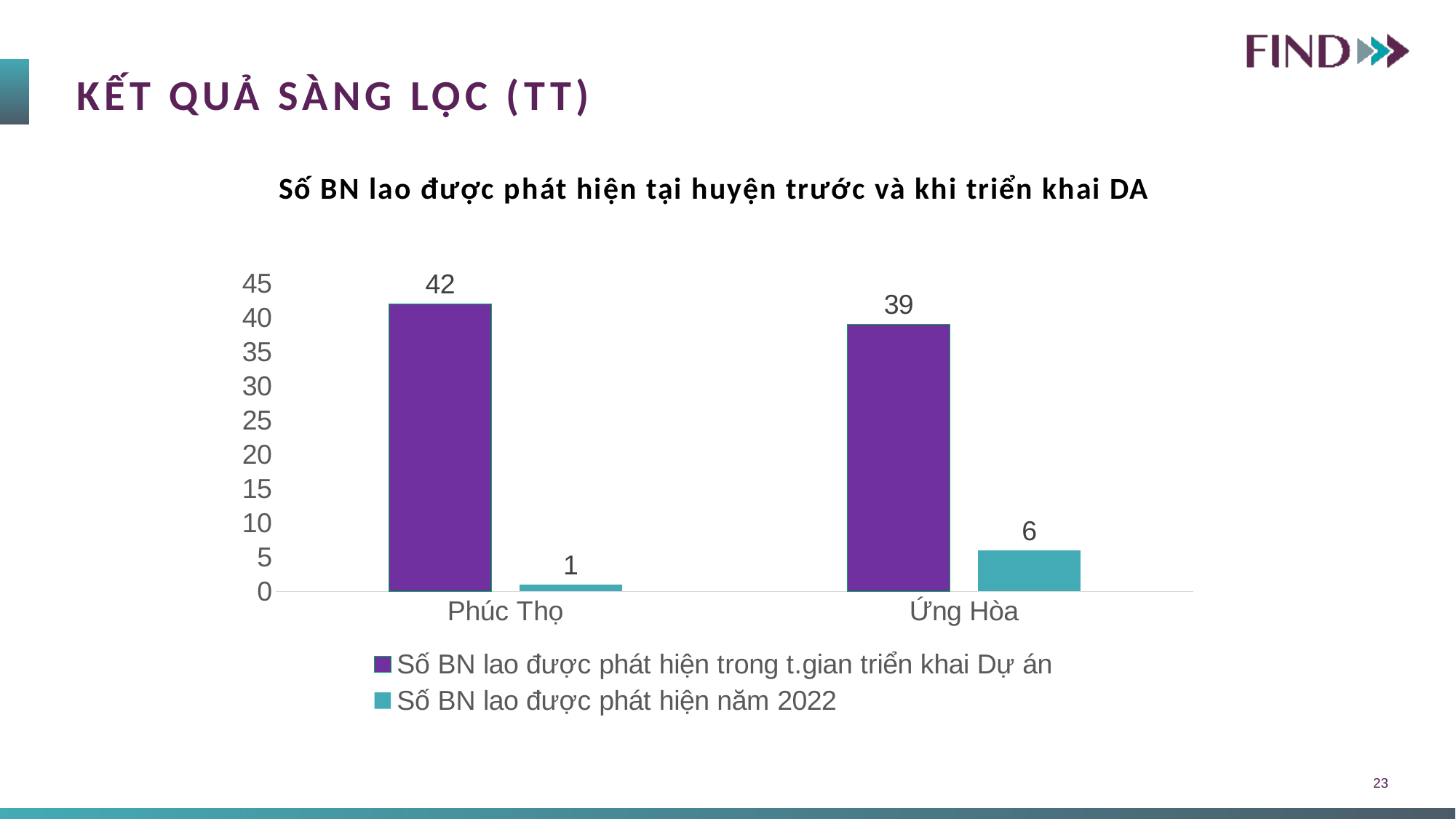
Which district has the lowest value for 'Số BN lao được phát hiện năm 2022'? Phúc Thọ What is the value of 'Số BN lao được phát hiện năm 2022' for Ứng Hòa? 6 Which district has the highest value for 'Số BN lao được phát hiện trong t.gian triển khai Dự án'? Phúc Thọ What is the value of 'Số BN lao được phát hiện năm 2022' for Phúc Thọ? 1 What is the value of 'Số BN lao được phát hiện trong t.gian triển khai Dự án' for Ứng Hòa? 39 What kind of chart is shown on the slide? Bar chart What is the difference between the two series values for Phúc Thọ? 41 What is the difference between the 'Số BN lao được phát hiện trong t.gian triển khai Dự án' values for Phúc Thọ and Ứng Hòa? 3 How many districts are shown on the x axis? 2 Which is larger: 'Số BN lao được phát hiện năm 2022' for Ứng Hòa or for Phúc Thọ? Ứng Hòa How many series does the legend list? 2 What is the value of 'Số BN lao được phát hiện trong t.gian triển khai Dự án' for Phúc Thọ? 42